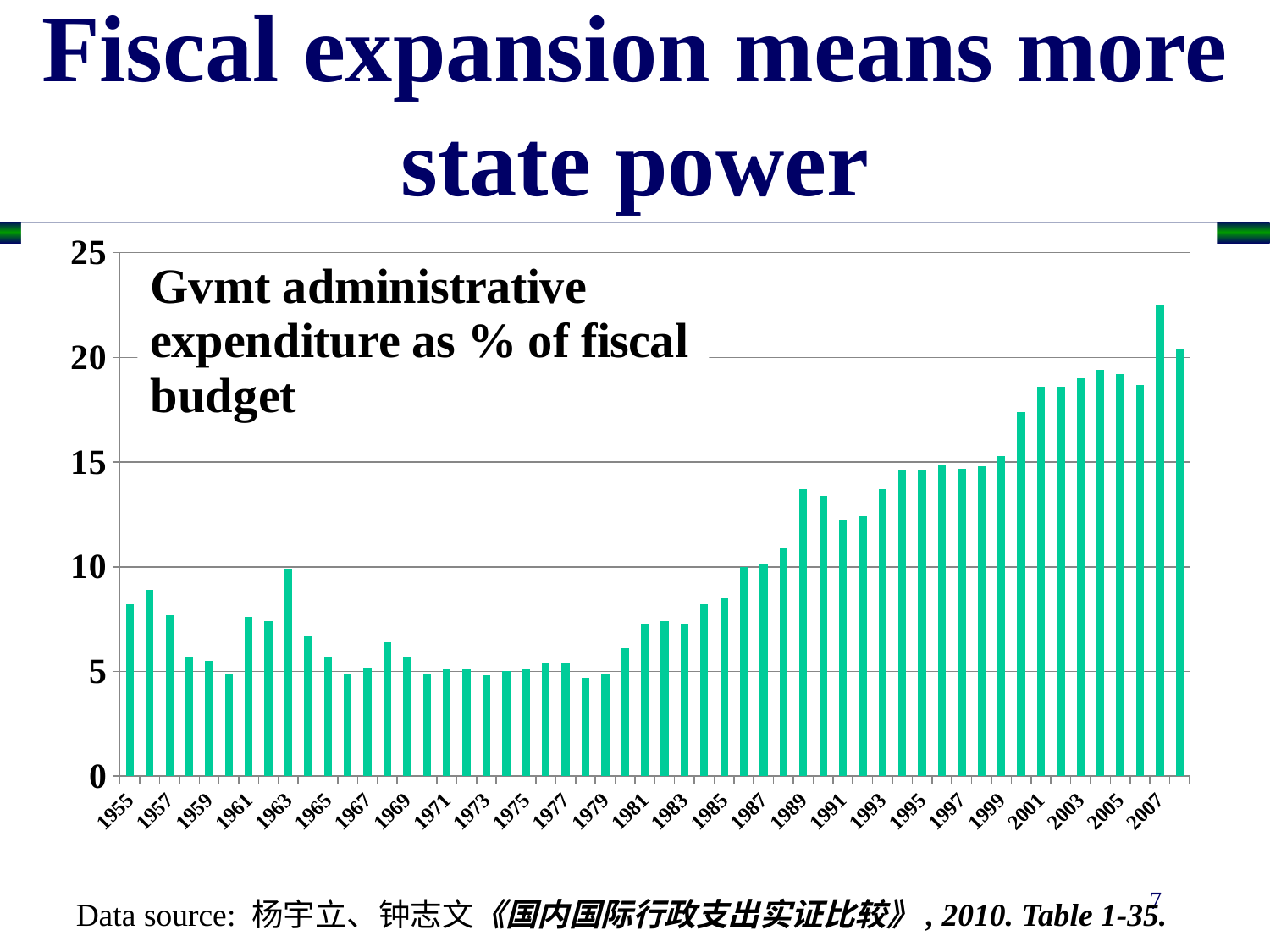
What is the title printed inside the chart? Gvmt administrative expenditure as % of fiscal budget Which year has the highest bar in the chart? 2007 Is the value for 2001 greater or less than 15? greater Do the values generally rise or fall from 1979 to 2007? rise What kind of chart is shown on the slide? bar chart Which year has the larger value, 1963 or 1965? 1963 Which year has the larger value, 1989 or 1991? 1989 What is the highest value shown on the vertical axis? 25 Is the value for 1989 greater or less than 10? greater Is the value for 2007 greater or less than 20? greater